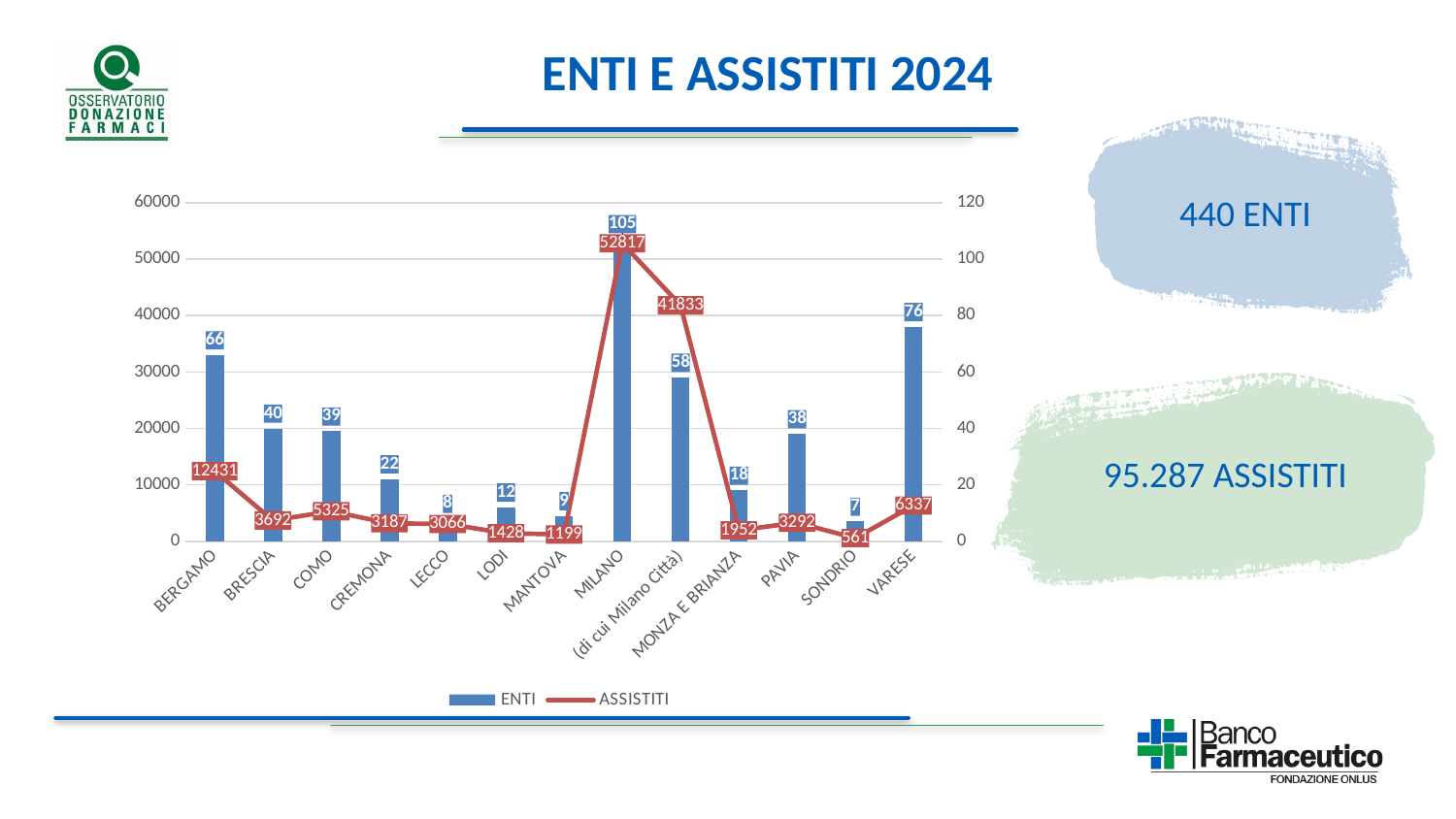
What is the ASSISTITI value for VARESE? 6337 How many series does the legend list? 2 What is the ENTI value for BERGAMO? 66 What kind of chart is shown on the slide? Combination bar and line chart Which category has the highest ENTI value? MILANO Which category has the lowest ASSISTITI value? SONDRIO Which has a larger ASSISTITI value, COMO or BRESCIA? COMO How many categories are shown on the x axis? 13 What is the difference between the ASSISTITI values for BERGAMO and VARESE? 6094 What is the ENTI value for PAVIA? 38 What is the ASSISTITI value for LECCO? 3066 What is the difference between the ENTI values for VARESE and BERGAMO? 10